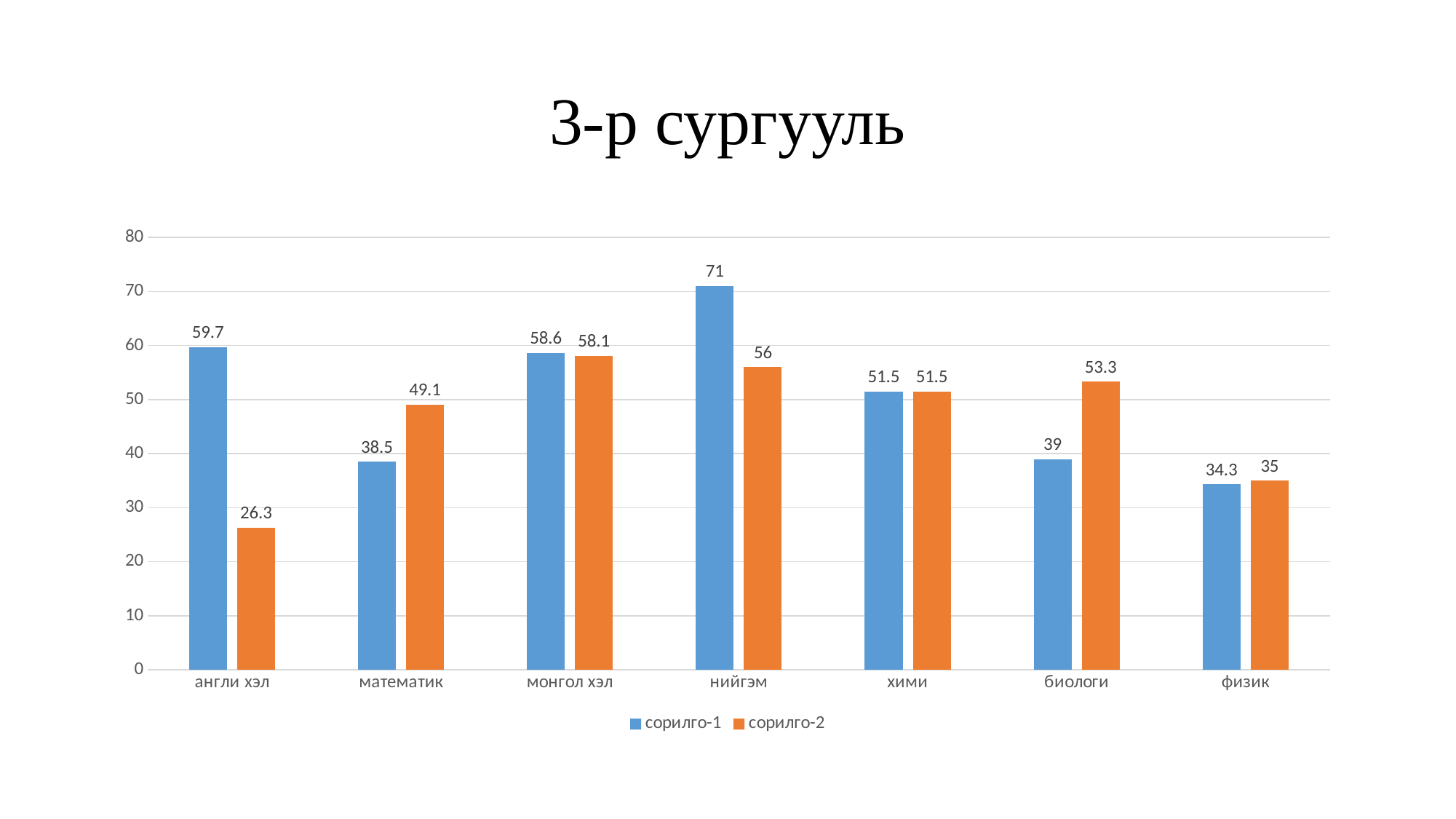
How many series does the legend list? 2 What is the difference between сорилго-1 and сорилго-2 in англи хэл? 33.4 What is the value for сорилго-1 in нийгэм? 71 Which is larger in биологи, сорилго-1 or сорилго-2? сорилго-2 Is the value for сорилго-1 in физик greater or less than 40? less What is the difference between сорилго-1 and сорилго-2 in нийгэм? 15 Which category has the lowest value for сорилго-2? англи хэл What is the value for сорилго-2 in математик? 49.1 How many categories are shown on the x axis? 7 What kind of chart is shown on the slide? bar chart Which category has the highest value for сорилго-1? нийгэм What is the value for сорилго-2 in англи хэл? 26.3